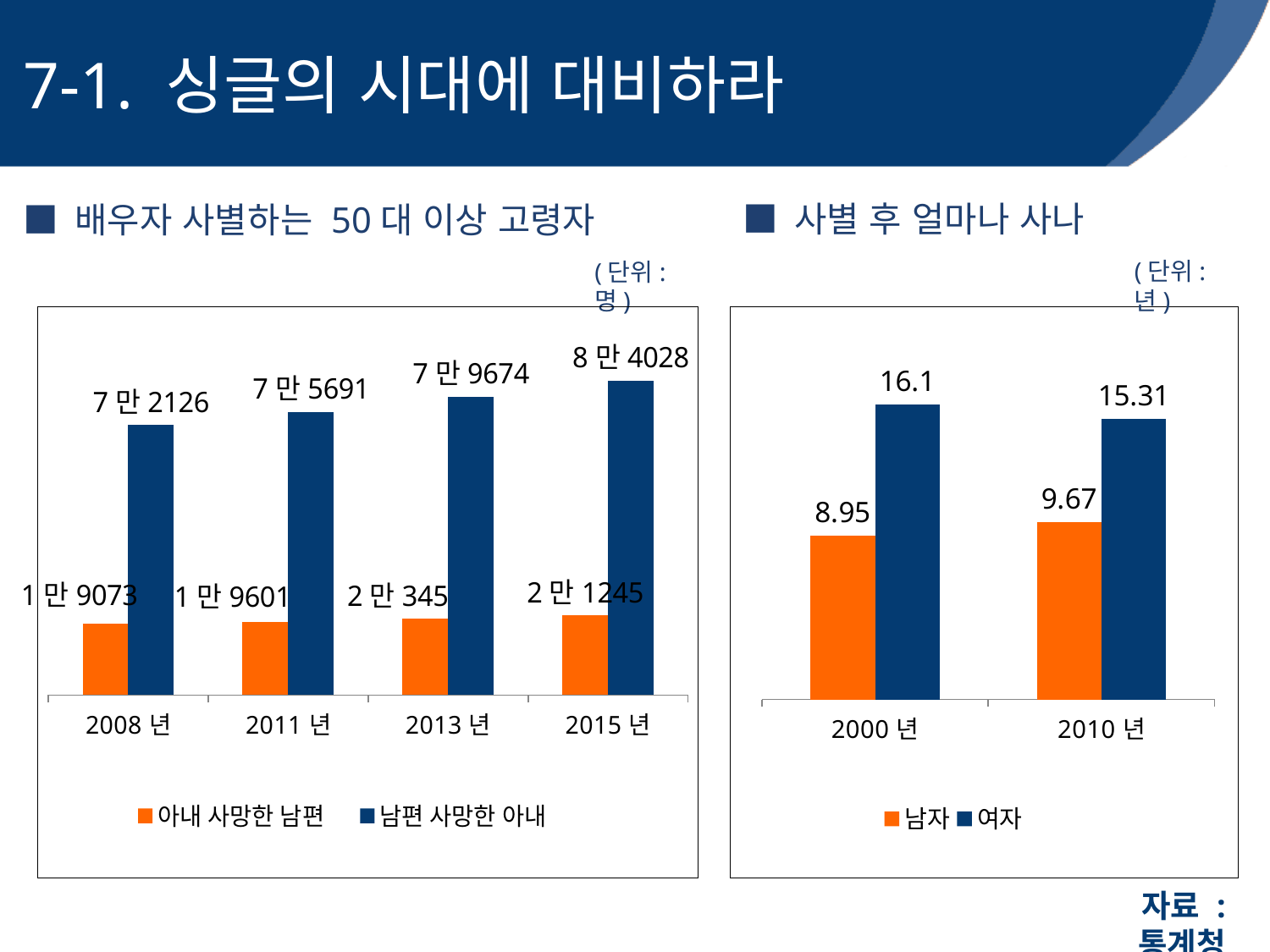
In the left chart (배우자 사별하는 50대 이상 고령자), what is the value for 아내 사망한 남편 in 2013 년? 2 만 345 In the left chart (배우자 사별하는 50대 이상 고령자), what is the value for 남편 사망한 아내 in 2015 년? 8 만 4028 In the left chart (배우자 사별하는 50대 이상 고령자), what is the value for 아내 사망한 남편 in 2008 년? 1 만 9073 In the left chart (배우자 사별하는 50대 이상 고령자), in which year is the value for 남편 사망한 아내 the highest? 2015 년 In the right chart (사별 후 얼마나 사나), what is the value for 여자 in 2000 년? 16.1 In the left chart (배우자 사별하는 50대 이상 고령자), how many series does the legend list? 2 In the right chart (사별 후 얼마나 사나), what is the value for 남자 in 2010 년? 9.67 In the left chart (배우자 사별하는 50대 이상 고령자), how many years are shown on the x axis? 4 In the right chart (사별 후 얼마나 사나), what is the difference between 여자 and 남자 in 2010 년? 5.64 In the left chart (배우자 사별하는 50대 이상 고령자), does the value for 남편 사망한 아내 rise or fall from 2008 년 to 2015 년? rise What kind of chart is the right chart (사별 후 얼마나 사나)? bar chart In the left chart (배우자 사별하는 50대 이상 고령자), in which year is the value for 아내 사망한 남편 the lowest? 2008 년